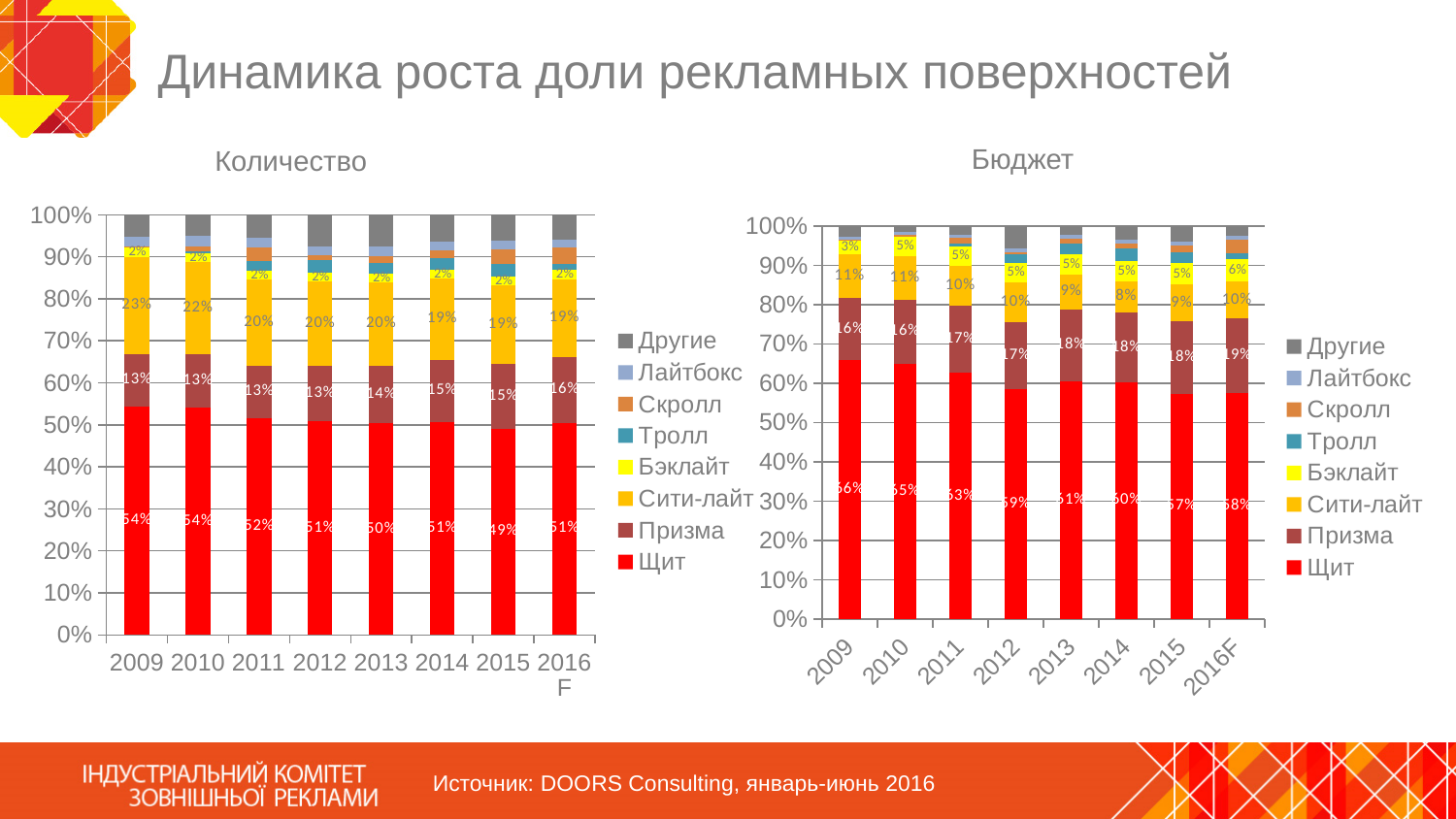
In the 'Бюджет' chart, what is the difference between the share of Щит in 2009 and in 2016F? 8% What kind of chart is the 'Количество' chart on the left? Stacked bar chart In the 'Бюджет' chart, what is the share of Щит in 2009? 66% In the 'Количество' chart, in which year is the share of Щит the lowest? 2015 How many series does the legend of the 'Количество' chart list? 8 How many years are shown on the x axis of the 'Бюджет' chart? 8 In the 'Количество' chart, what is the share of Щит in 2009? 54% In the 'Бюджет' chart, what is the share of Призма in 2016F? 19% In the 'Количество' chart, which is larger: the share of Сити-лайт in 2009 or in 2016F? 2009 In the 'Количество' chart, what is the share of Сити-лайт in 2016F? 19% In the 'Бюджет' chart, in which year is the share of Щит the highest? 2009 In the 'Бюджет' chart, what is the share of Бэклайт in 2009? 3%